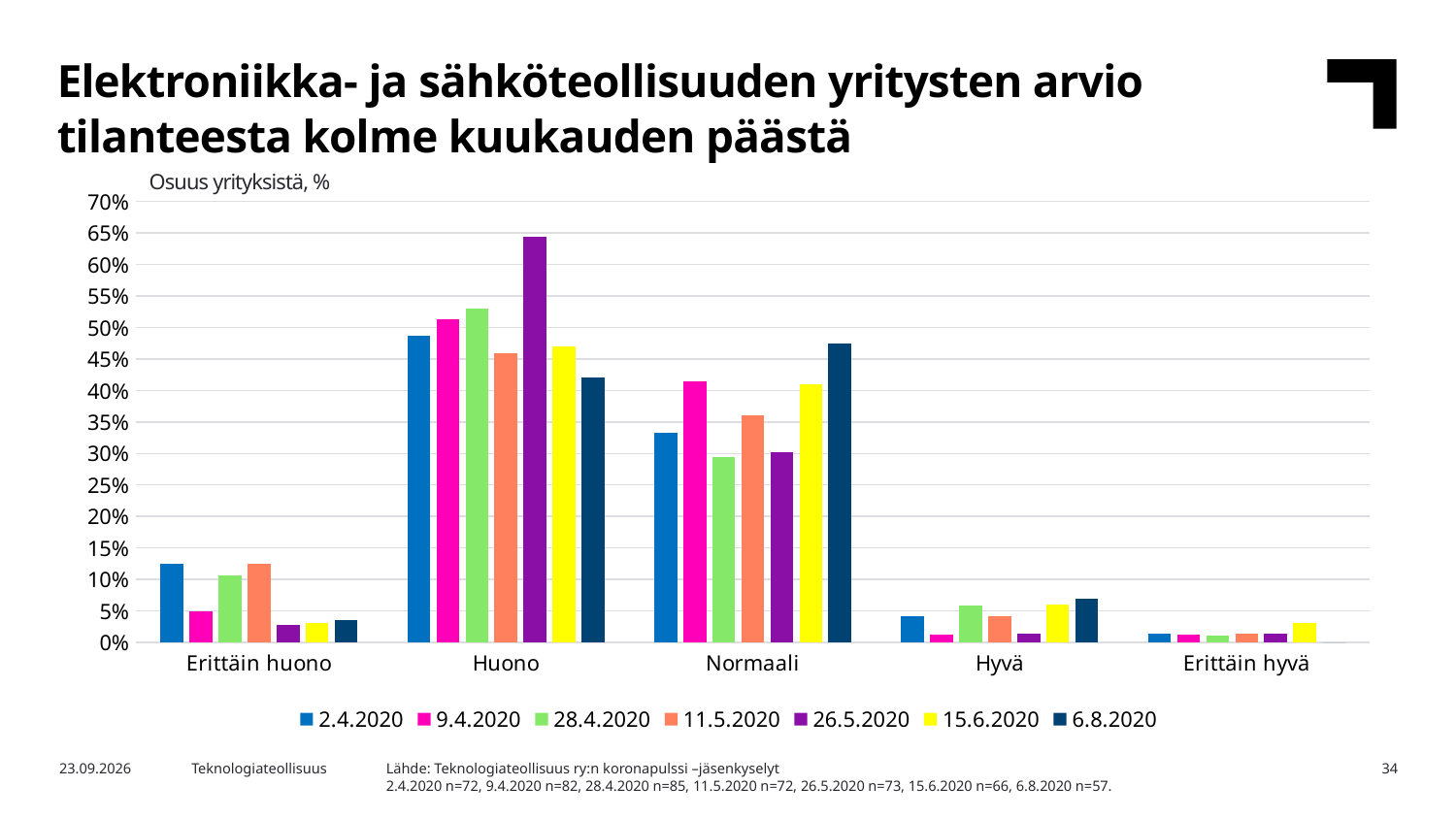
Which series has the highest value in the Huono category? 26.5.2020 Is the value for 28.4.2020 in the Normaali category greater or less than 35%? less Is the value for 26.5.2020 in the Huono category greater or less than 60%? greater What is the label shown above the y axis of the chart? Osuus yrityksistä, % For the 2.4.2020 series, which category has the larger value: Huono or Normaali? Huono Is the value for 2.4.2020 in the Erittäin huono category greater or less than 10%? greater What kind of chart is shown on the slide? bar chart How many categories are shown on the x axis of the chart? 5 In the Erittäin huono category, which is larger: the value for 2.4.2020 or the value for 9.4.2020? 2.4.2020 How many series does the chart legend list? 7 Which series has the highest value in the Normaali category? 6.8.2020 Which series has the lowest value in the Huono category? 6.8.2020